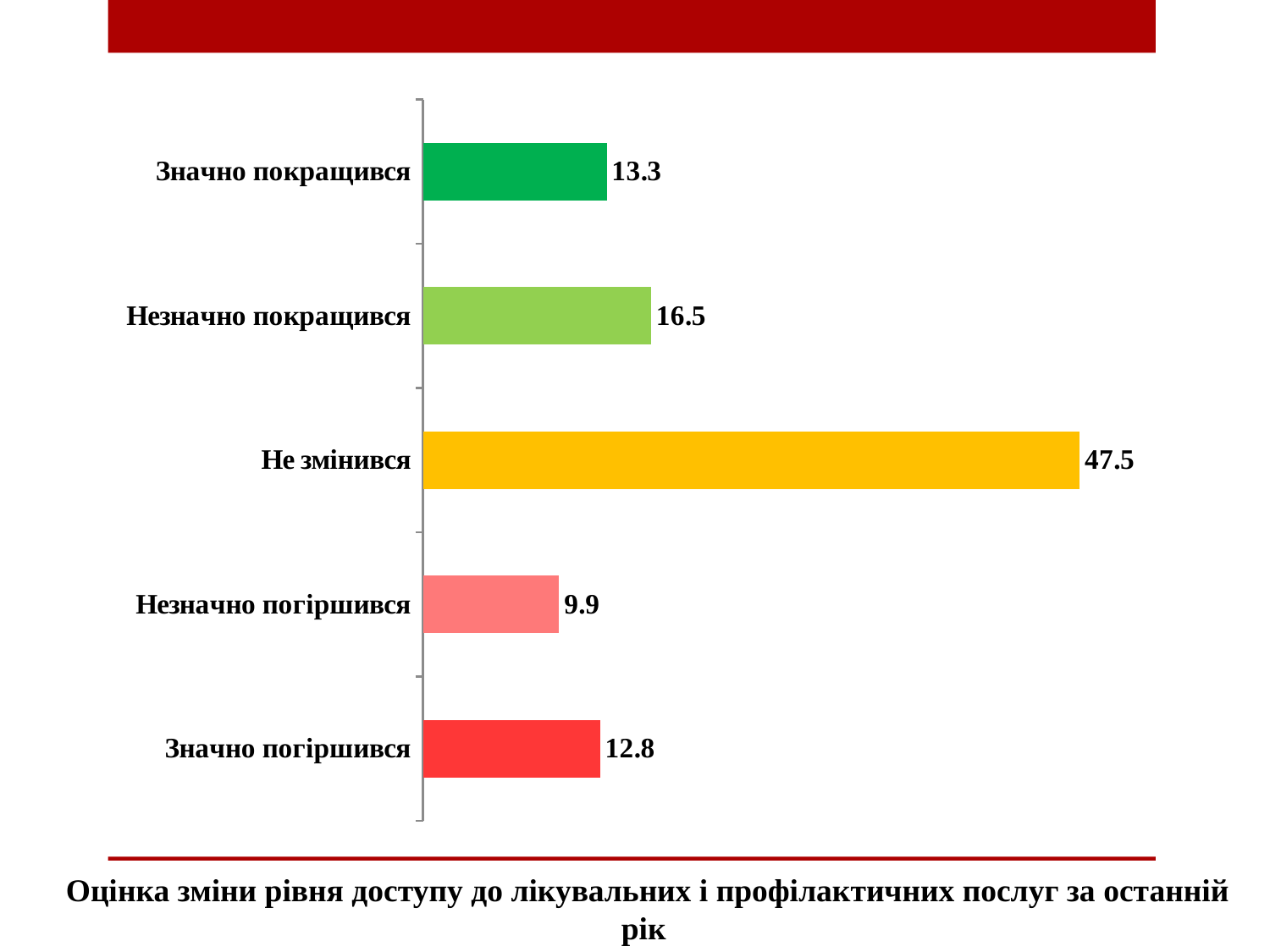
What is the difference between the values for "Значно покращився" and "Значно погіршився"? 0.5 What is the value for "Не змінився"? 47.5 What is the value for "Значно покращився"? 13.3 What is the value for "Значно погіршився"? 12.8 What kind of chart is shown on the slide? bar chart What is the value for "Незначно погіршився"? 9.9 Which category has the lowest value? Незначно погіршився Which category has the highest value? Не змінився Which is larger, the value for "Незначно покращився" or the value for "Незначно погіршився"? Незначно покращився What is the difference between the values for "Не змінився" and "Незначно покращився"? 31.0 How many categories are shown in the chart? 5 What colour is the bar for "Не змінився"? yellow